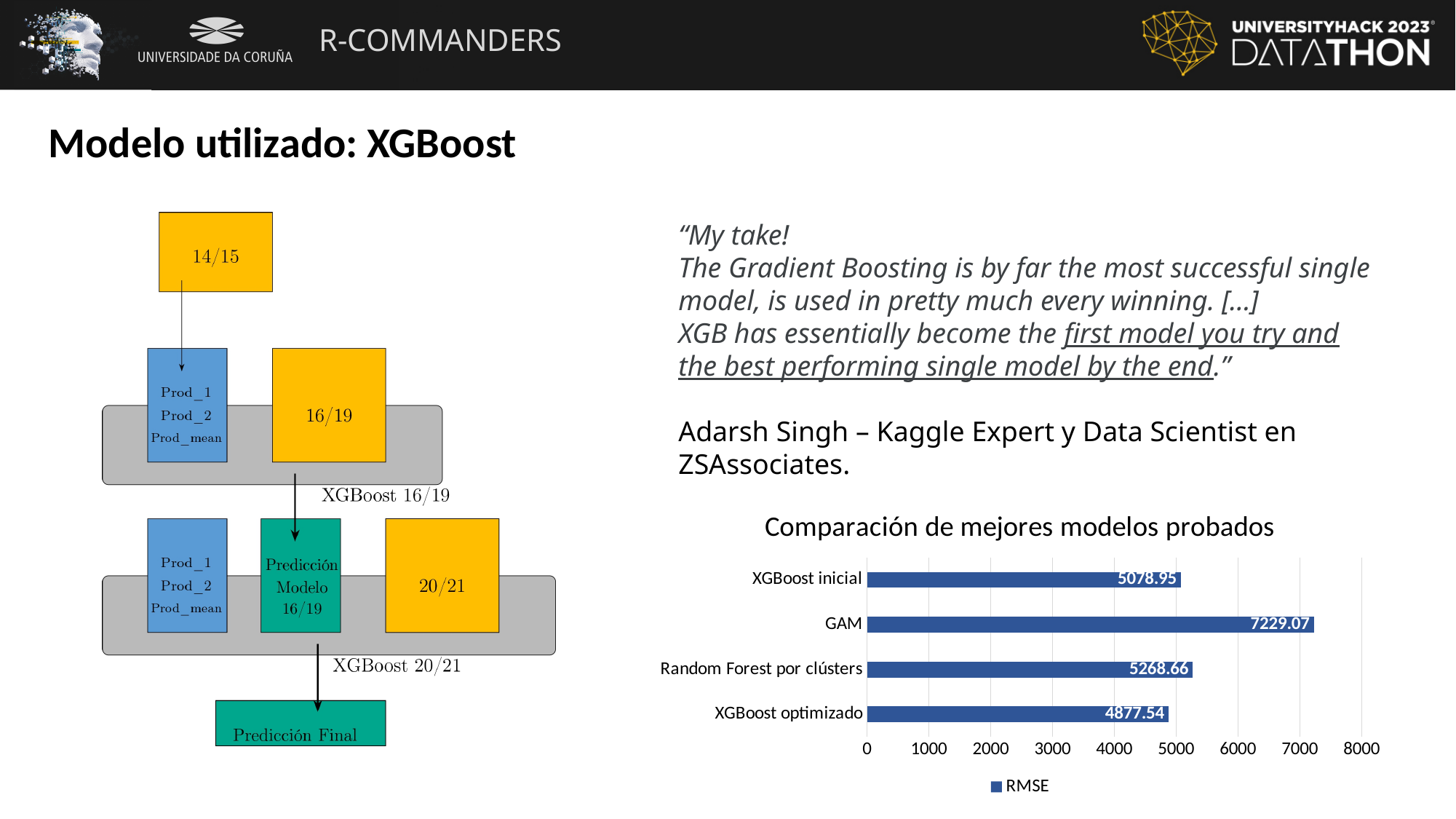
What is the RMSE value for GAM? 7229.07 How many models are compared in the chart? 4 Which model has the lowest RMSE? XGBoost optimizado Which has a larger RMSE, Random Forest por clústers or XGBoost inicial? Random Forest por clústers What is the difference in RMSE between GAM and XGBoost optimizado? 2351.53 What is the RMSE value for XGBoost optimizado? 4877.54 Which model has the highest RMSE? GAM What is the RMSE value for Random Forest por clústers? 5268.66 What is the difference in RMSE between XGBoost inicial and XGBoost optimizado? 201.41 What is the RMSE value for XGBoost inicial? 5078.95 What type of chart is used to compare the models? Bar chart What is the title of the chart? Comparación de mejores modelos probados